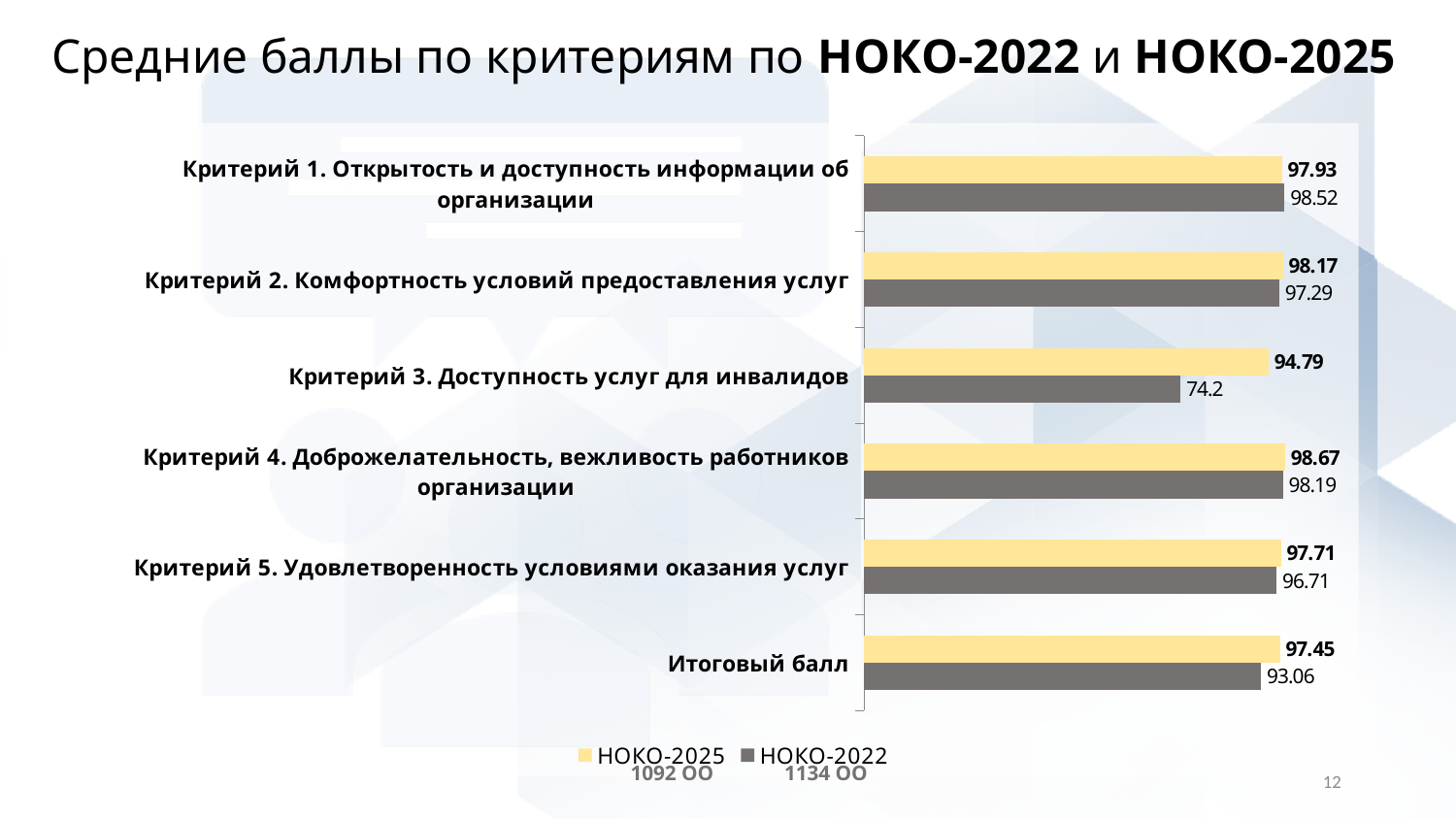
Which category has the lowest НОКО-2022 value? Критерий 3. Доступность услуг для инвалидов Which category has the highest НОКО-2025 value? Критерий 4. Доброжелательность, вежливость работников организации What is the НОКО-2025 value for Критерий 1. Открытость и доступность информации об организации? 97.93 How many series does the legend list? 2 What is the НОКО-2022 value for Критерий 3. Доступность услуг для инвалидов? 74.2 How many categories are shown in the chart? 6 What is the difference between the НОКО-2025 and НОКО-2022 values for Итоговый балл? 4.39 For Критерий 1. Открытость и доступность информации об организации, which is larger: the НОКО-2025 value or the НОКО-2022 value? НОКО-2022 What is the НОКО-2022 value for Итоговый балл? 93.06 What kind of chart is shown on the slide? Bar chart What is the difference between the НОКО-2025 and НОКО-2022 values for Критерий 3. Доступность услуг для инвалидов? 20.59 What is the НОКО-2025 value for Критерий 3. Доступность услуг для инвалидов? 94.79